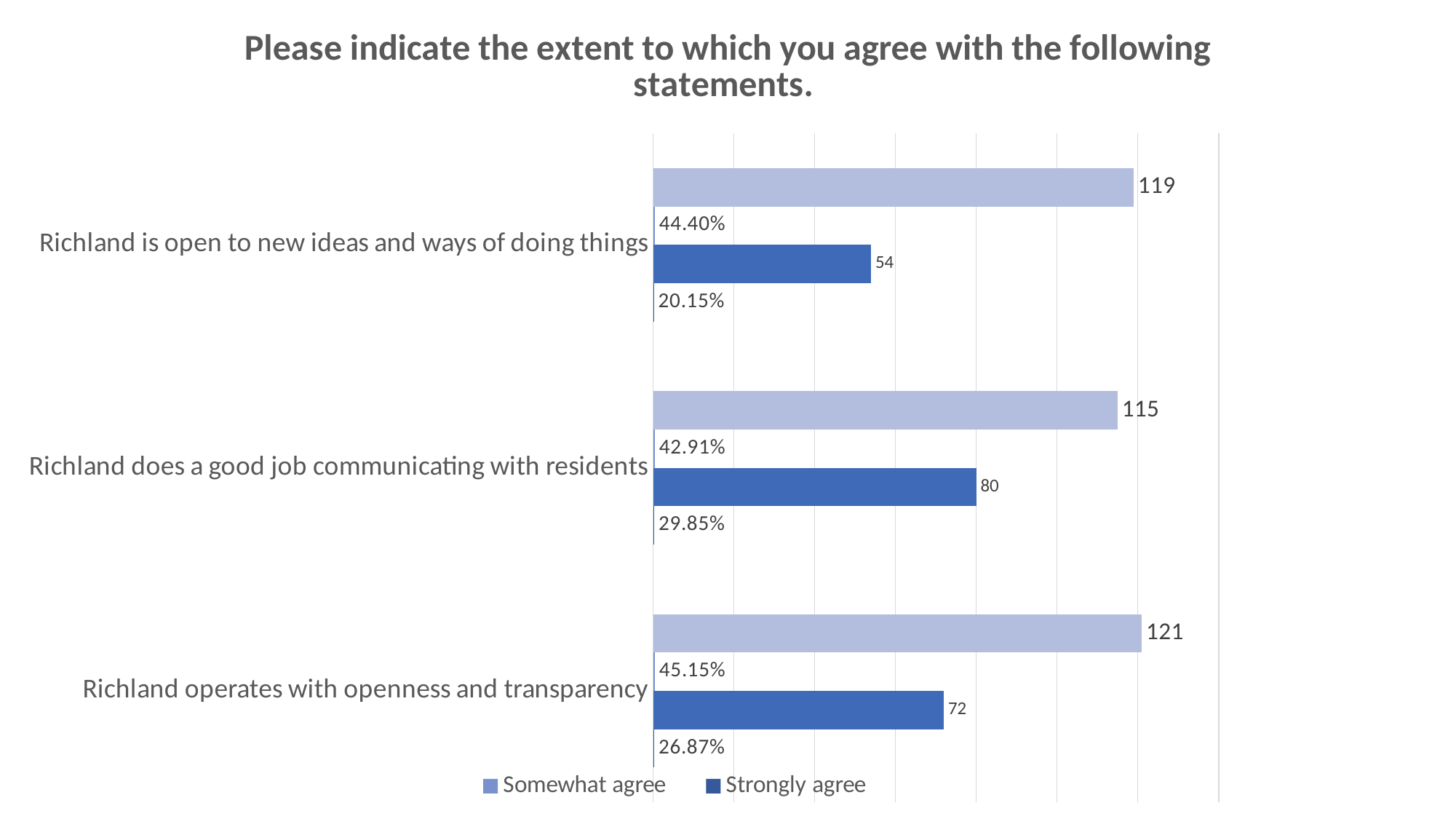
What is the 'Somewhat agree' count for 'Richland is open to new ideas and ways of doing things'? 119 What is the 'Strongly agree' count for 'Richland does a good job communicating with residents'? 80 Which is larger: the 'Strongly agree' count for 'Richland does a good job communicating with residents' or for 'Richland operates with openness and transparency'? Richland does a good job communicating with residents How many statements (categories) are shown in the chart? 3 Which statement has the highest 'Somewhat agree' count? Richland operates with openness and transparency What percentage is shown for 'Strongly agree' on 'Richland operates with openness and transparency'? 26.87% What percentage is shown for 'Somewhat agree' on 'Richland is open to new ideas and ways of doing things'? 44.40% What kind of chart is shown on the slide? Bar chart How many series does the legend list? 2 What are the two series named in the legend? Somewhat agree and Strongly agree Which statement has the lowest 'Strongly agree' count? Richland is open to new ideas and ways of doing things What is the difference between the 'Somewhat agree' and 'Strongly agree' counts for 'Richland is open to new ideas and ways of doing things'? 65